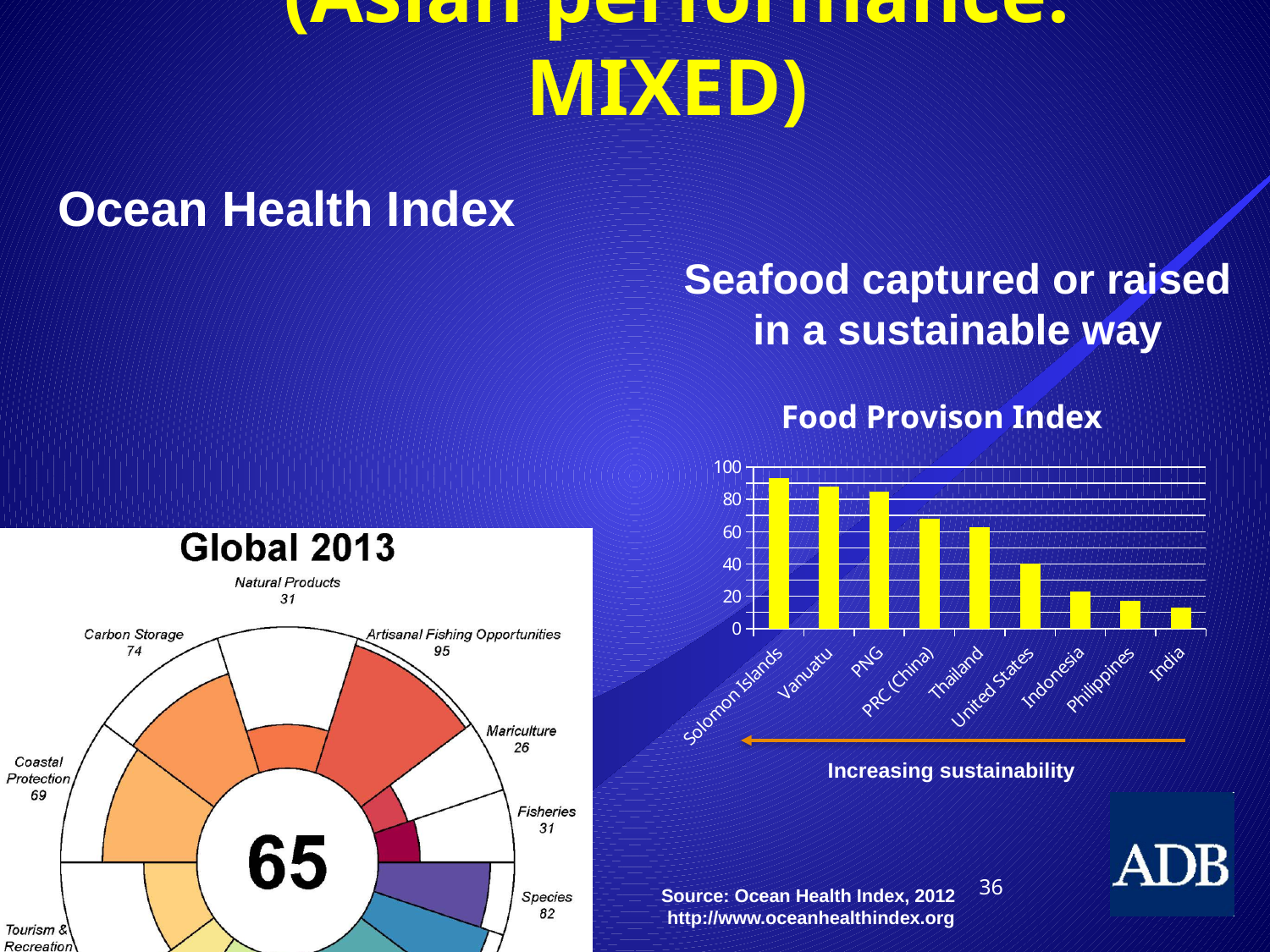
How many countries are shown on the Food Provison Index chart? 9 What kind of chart is the Food Provison Index chart? bar chart On the Global 2013 Ocean Health Index chart, what is the difference between Carbon Storage and Coastal Protection? 5 On the Food Provison Index chart, is the value for India greater or less than 20? less On the Global 2013 Ocean Health Index chart, what is the value for Artisanal Fishing Opportunities? 95 On the Food Provison Index chart, which has the larger value, Thailand or Indonesia? Thailand On the Food Provison Index chart, do the values rise or fall from left to right along the x axis? fall On the Food Provison Index chart, which country has the lowest value? India On the Global 2013 Ocean Health Index chart, what is the value for Carbon Storage? 74 On the Food Provison Index chart, is the value for United States greater or less than 60? less On the Food Provison Index chart, which country has the highest value? Solomon Islands On the Food Provison Index chart, is the value for Solomon Islands greater or less than 80? greater